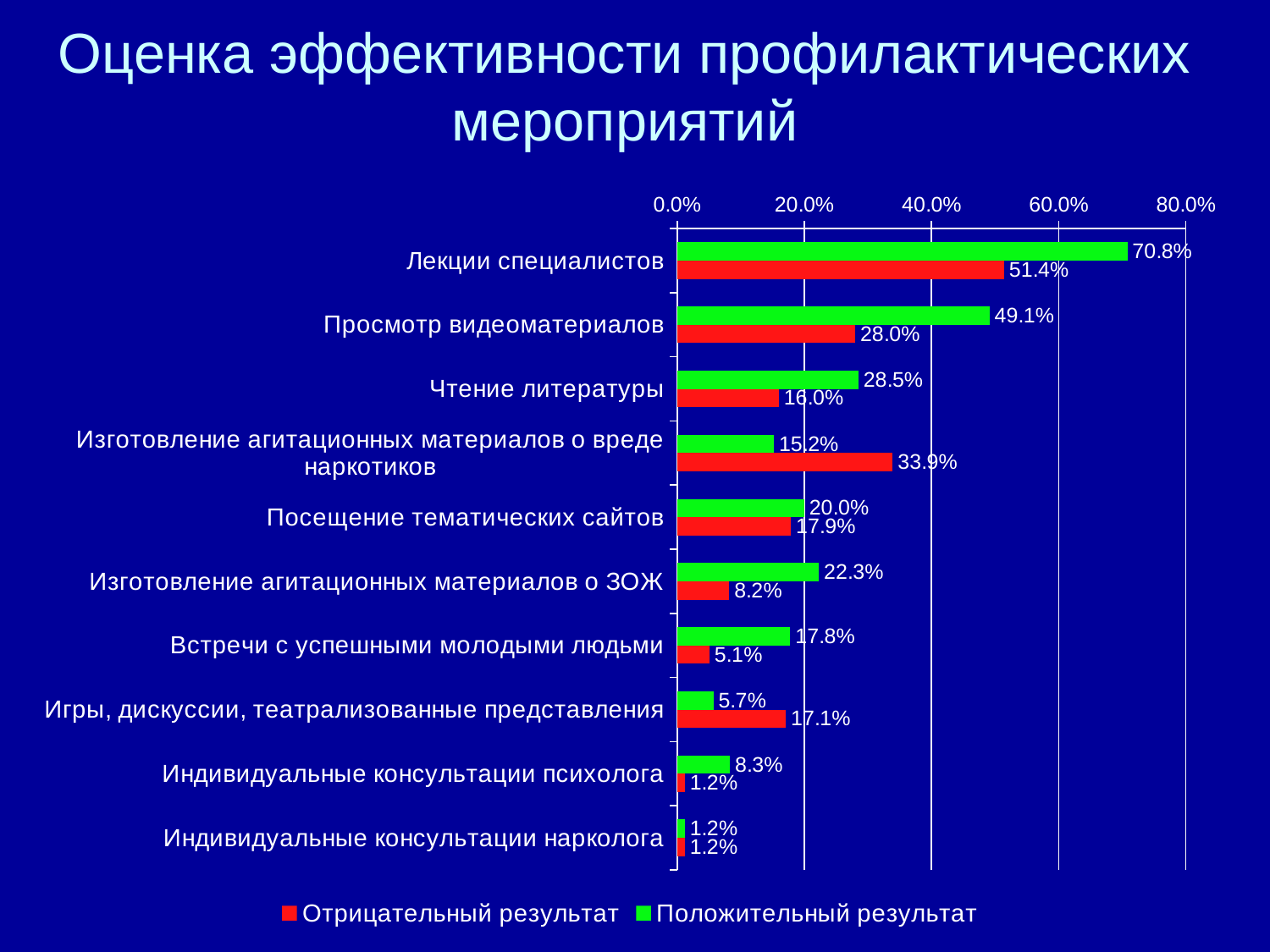
What is the Отрицательный результат value for Просмотр видеоматериалов? 28.0% What is the Отрицательный результат value for Изготовление агитационных материалов о вреде наркотиков? 33.9% Is the Отрицательный результат value for Лекции специалистов greater or less than 40.0%? greater How many categories are shown on the chart? 10 Which category has the lowest Положительный результат value? Индивидуальные консультации нарколога What is the Положительный результат value for Лекции специалистов? 70.8% For Игры, дискуссии, театрализованные представления, which is larger: the Отрицательный результат or the Положительный результат value? Отрицательный результат What kind of chart is shown on the slide? Bar chart How many series does the legend list? 2 Which category has the highest Положительный результат value? Лекции специалистов What is the difference between the Положительный результат and Отрицательный результат values for Чтение литературы? 12.5% Which colour represents Положительный результат in the chart? Green